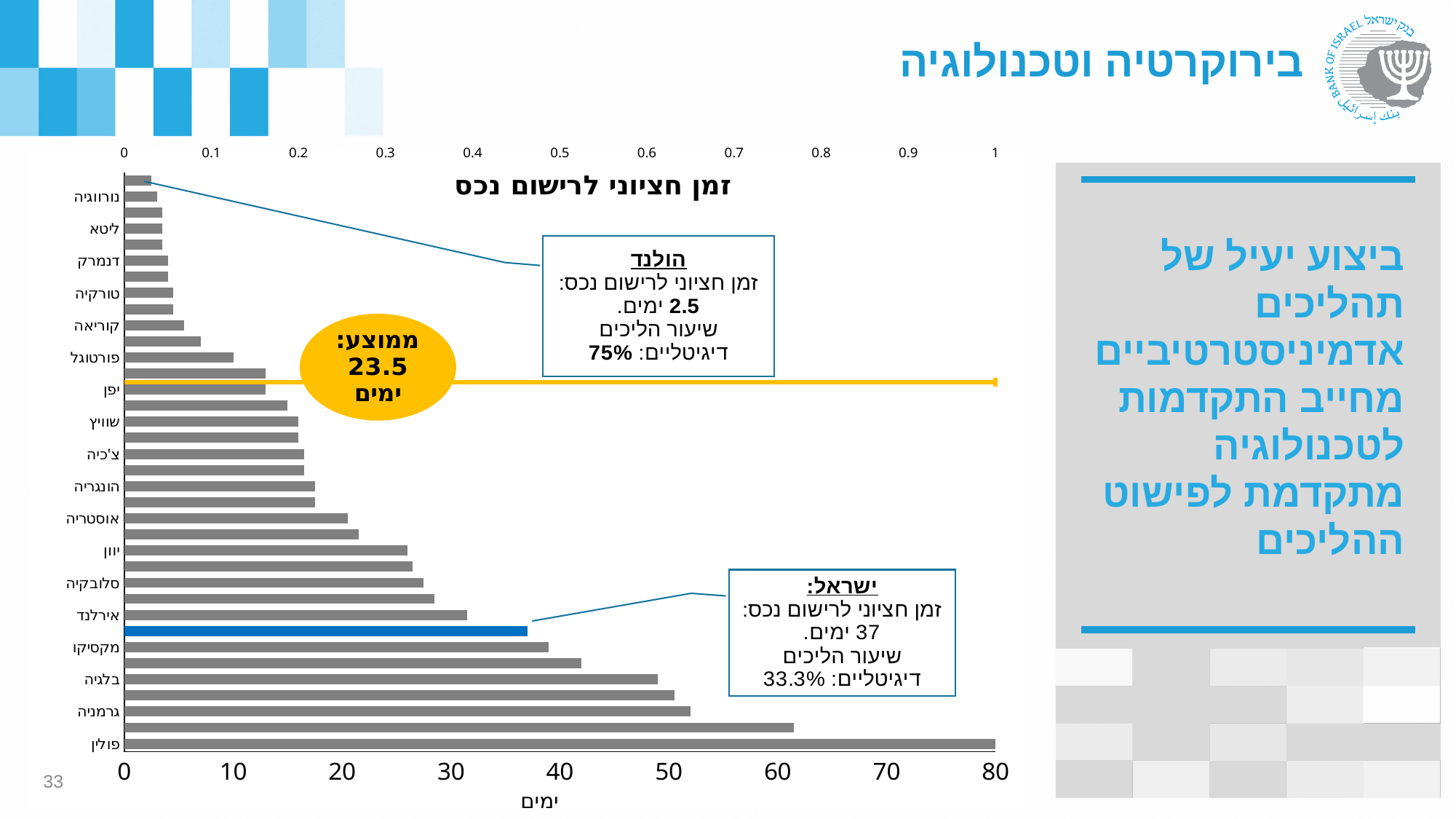
What is the title of the chart? זמן חציוני לרישום נכס Which country's bar is highlighted in blue? ישראל According to the callout, what is the median time to register property in Israel (ישראל)? 37 ימים According to the callout, what is the share of digital processes in Israel? 33.3% Is Israel's median registration time greater or less than the average of 23.5 days? greater What kind of chart is shown on the slide? bar chart What is the difference between Israel's median registration time (37 days) and Holland's (2.5 days)? 34.5 ימים What is the average (ממוצע) value marked on the chart? 23.5 ימים Is the value for הונגריה greater or less than 20? less Which country has the longest median time to register property? פולין Is the value for יוון greater or less than 20? greater According to the callout, what is the median time to register property in Holland (הולנד)? 2.5 ימים